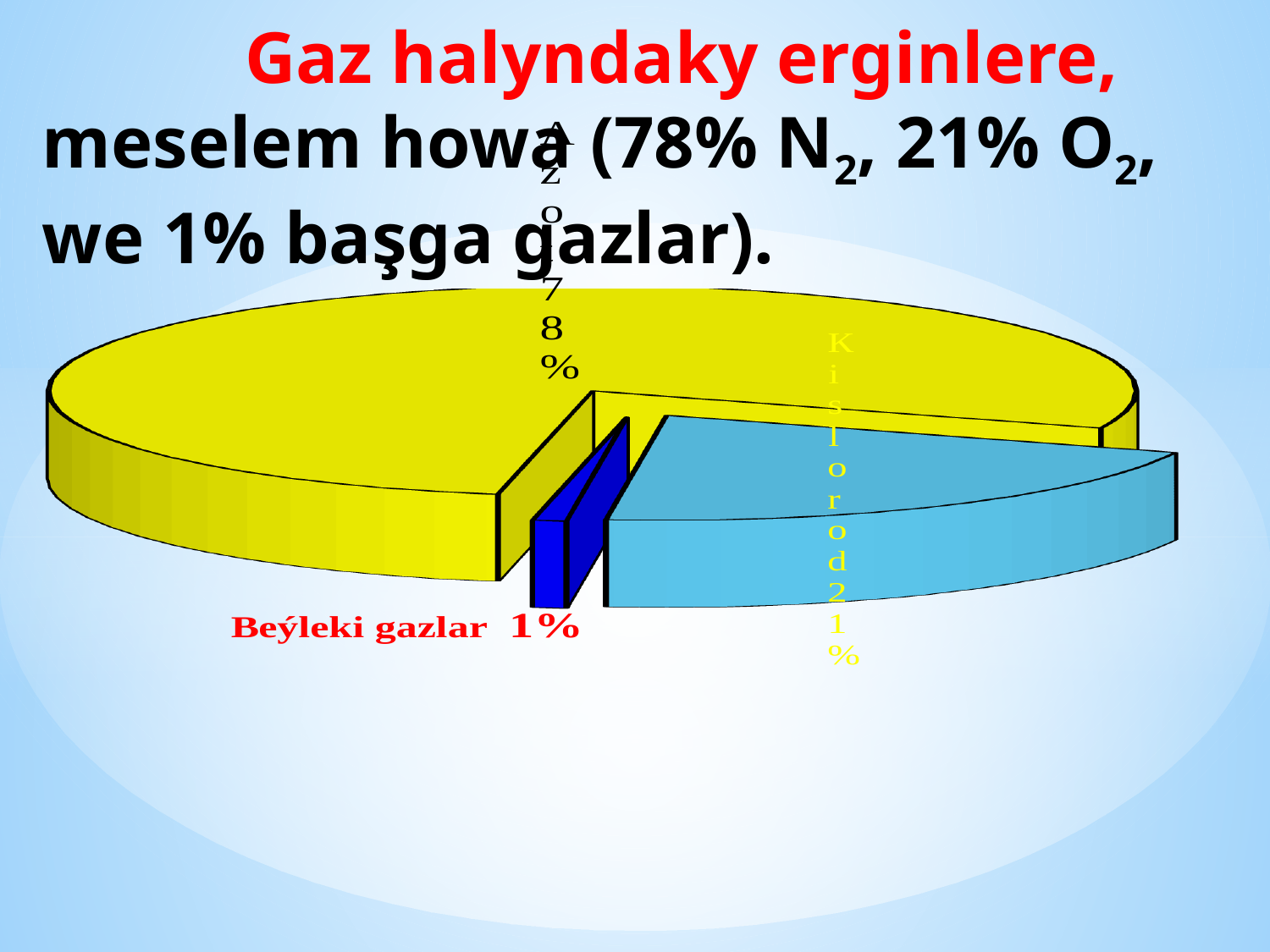
What share of the pie does the Azot slice represent? 78% How many slices does the pie chart have? 3 What kind of chart is shown on the slide? pie chart Which slice of the pie chart is the smallest? Beýleki gazlar What colour is the Beýleki gazlar slice in the pie chart? dark blue What colour is the Azot slice in the pie chart? yellow What share of the pie does the Kislorod slice represent? 21% What is the difference in percentage points between the Azot slice and the Kislorod slice? 57 Which slice of the pie chart is the largest? Azot Which is larger, the Kislorod slice or the Beýleki gazlar slice? Kislorod What share of the pie does the Beýleki gazlar slice represent? 1% What is the difference in percentage points between the Kislorod slice and the Beýleki gazlar slice? 20